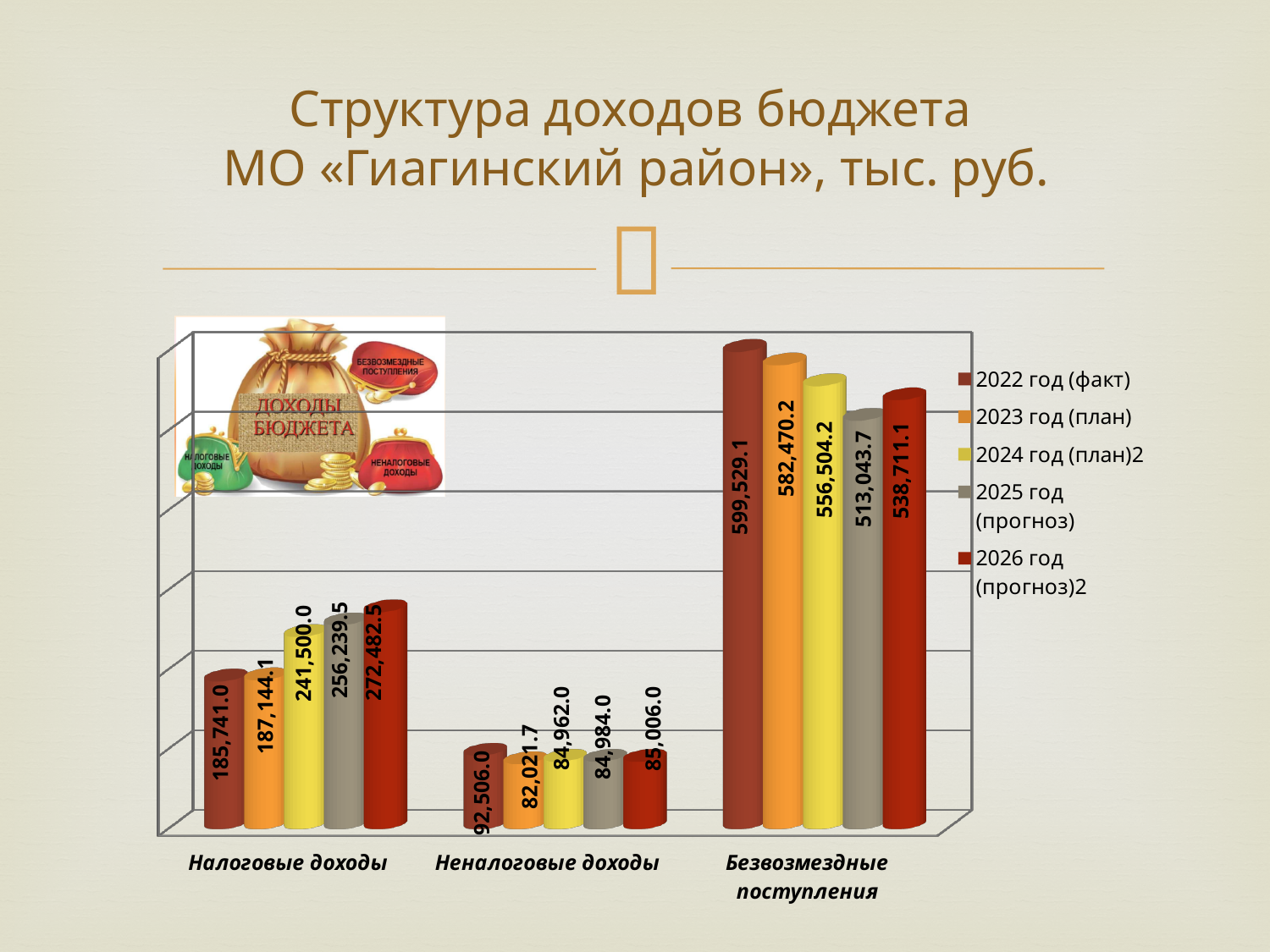
What is the value for Налоговые доходы in the 2022 год (факт) series? 185,741.0 Do the values for Налоговые доходы rise or fall from the 2022 год (факт) series to the 2026 год (прогноз)2 series? Rise What is the value for Неналоговые доходы in the 2023 год (план) series? 82,021.7 How many categories are shown on the x axis? 3 What is the value for Безвозмездные поступления in the 2025 год (прогноз) series? 513,043.7 Which is larger for Безвозмездные поступления: the 2022 год (факт) value or the 2025 год (прогноз) value? 2022 год (факт) What kind of chart is shown on the slide? Bar chart What is the difference between the 2026 год (прогноз)2 and 2022 год (факт) values for Налоговые доходы? 86,741.5 Which category has the highest value in the 2026 год (прогноз)2 series? Безвозмездные поступления How many series does the legend list? 5 What is the title of the slide? Структура доходов бюджета МО «Гиагинский район», тыс. руб. Which category has the lowest value in the 2024 год (план)2 series? Неналоговые доходы